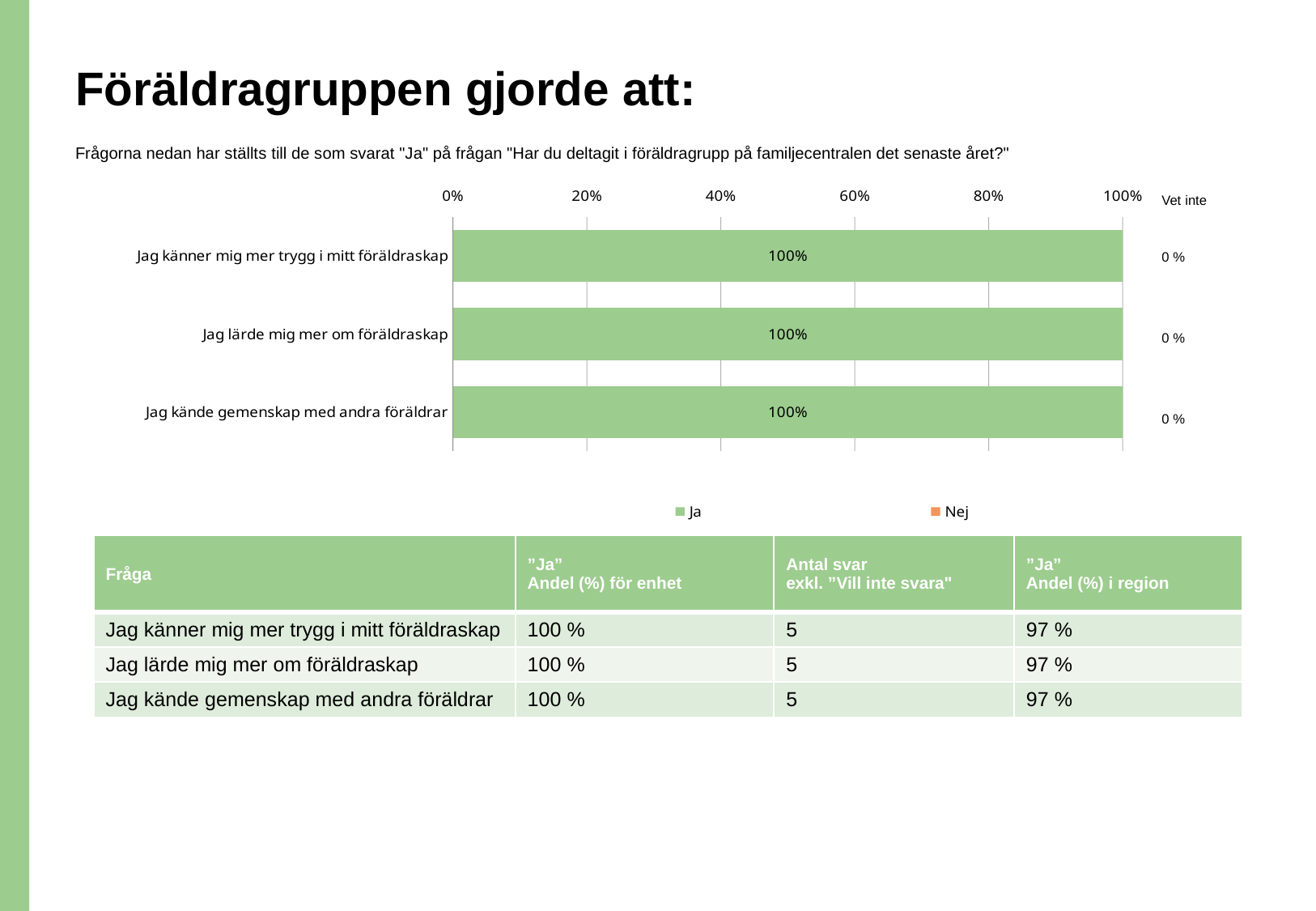
What is the "Vet inte" value shown next to the bar for "Jag lärde mig mer om föräldraskap"? 0 % What is the difference between the "Ja" values for "Jag lärde mig mer om föräldraskap" and "Jag kände gemenskap med andra föräldrar"? 0% How many categories are plotted in the chart? 3 What kind of chart is shown on the slide? bar chart What is the "Ja" value for "Jag lärde mig mer om föräldraskap"? 100% What is the "Ja" value for "Jag kände gemenskap med andra föräldrar"? 100% What is the "Ja" value for "Jag känner mig mer trygg i mitt föräldraskap"? 100% What is the highest value shown on the chart's percentage axis? 100% Is the "Ja" value for "Jag kände gemenskap med andra föräldrar" greater or less than 80%? greater How many series does the chart legend list? 2 Is the "Ja" value for "Jag känner mig mer trygg i mitt föräldraskap" greater or less than 60%? greater What are the two series named in the chart legend? Ja and Nej